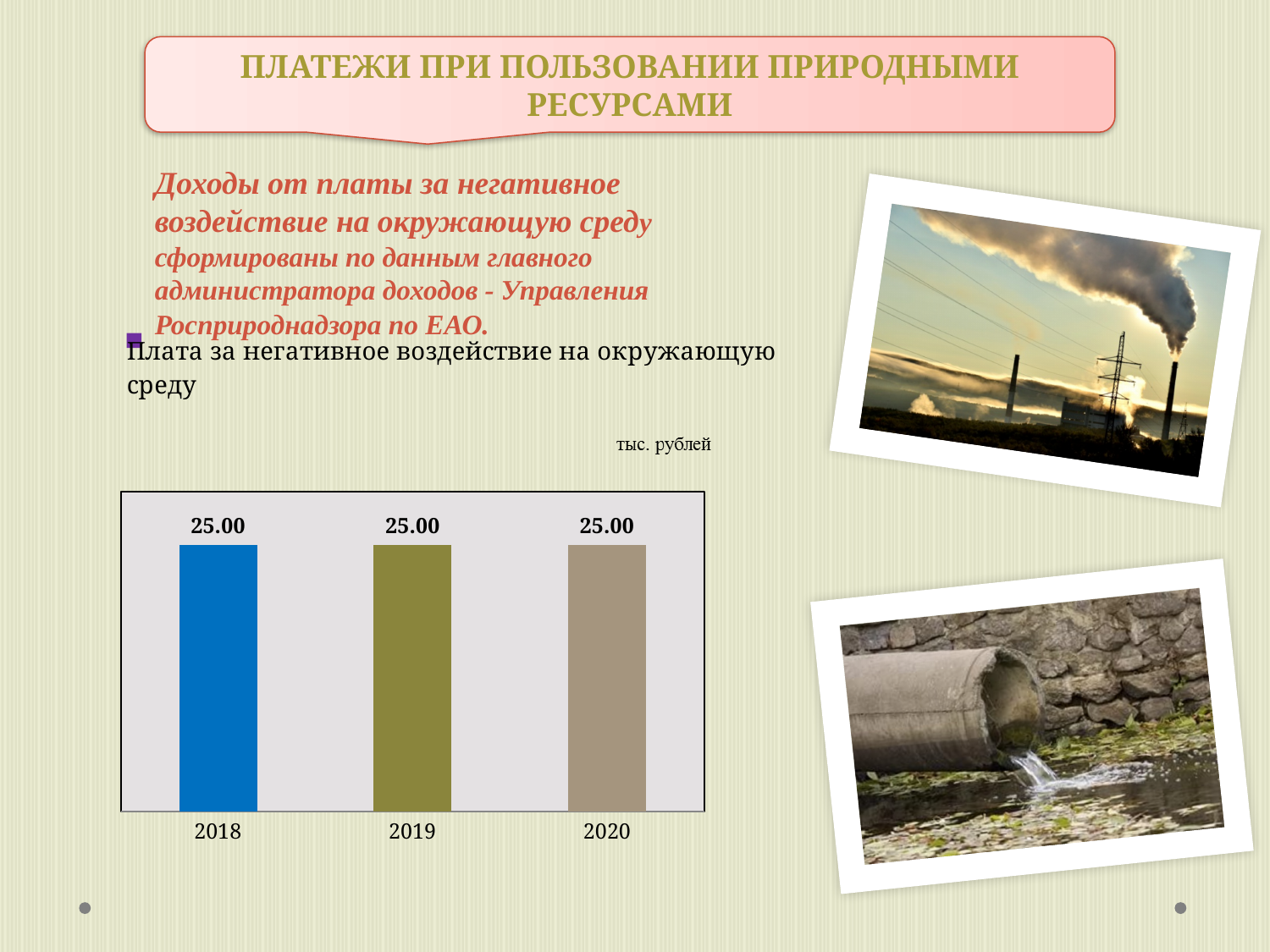
What is the title of the chart? Плата за негативное воздействие на окружающую среду In what units are the chart values given? тыс. рублей What is the value for 2020? 25.00 Is the value for 2019 larger than, smaller than or equal to the value for 2020? Equal What is the value for 2019? 25.00 How many years are shown on the chart? 3 What is the difference between the values for 2020 and 2018? 0.00 What kind of chart is shown on the slide? Bar chart Do the values rise, fall or stay the same from 2018 to 2020? Stay the same What is the value for 2018? 25.00